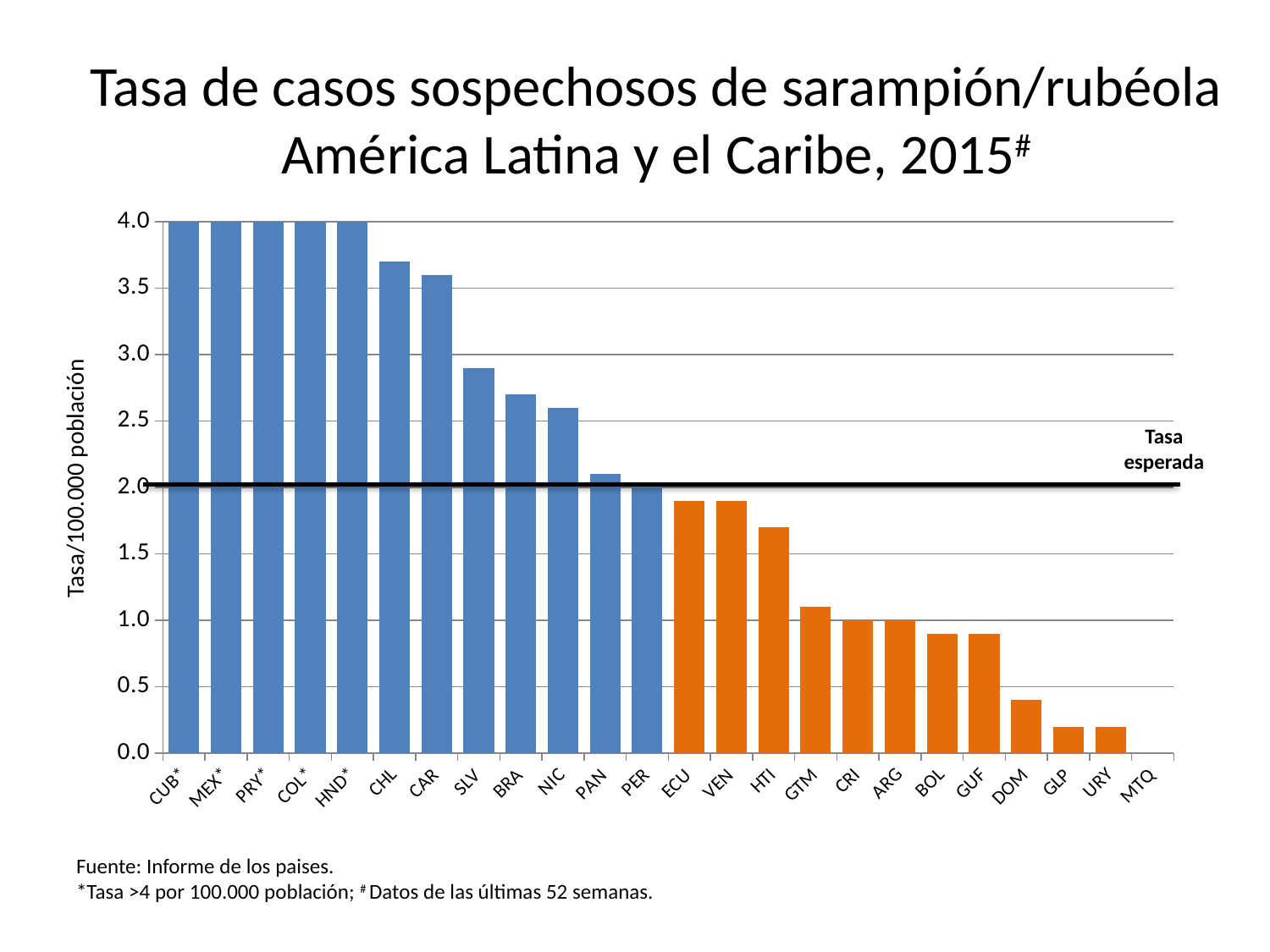
How many countries/categories are shown on the x axis? 24 Is the value for CHL greater or less than 3.5? greater Which category has the lowest value? MTQ Do the values rise or fall moving from left to right along the x axis? fall What is the value for PER? 2.0 Which is larger, the value for CHL or the value for SLV? CHL What is the value for MTQ? 0.0 What is the value for CRI? 1.0 What type of chart is shown on the slide? bar chart Is the value for HTI greater or less than 1.5? greater Is the value for BRA greater or less than 3.0? less What is the label of the horizontal line drawn across the chart at 2.0? Tasa esperada